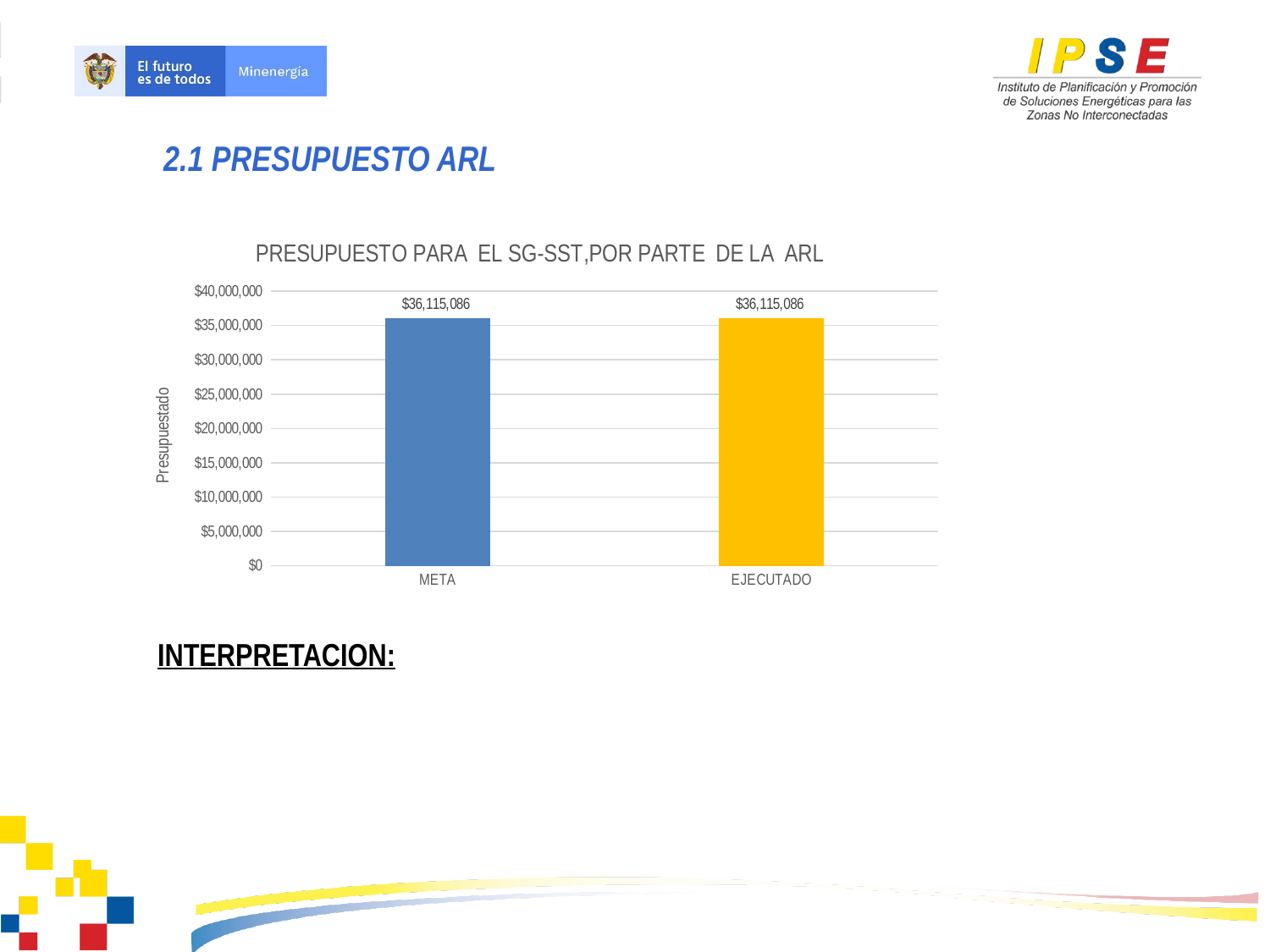
What kind of chart is shown? bar chart What is the total of the META and EJECUTADO values? $72,230,172 What is the title of the chart? PRESUPUESTO PARA EL SG-SST,POR PARTE DE LA ARL Is the value for EJECUTADO greater or less than $40,000,000? less What is the value for EJECUTADO? $36,115,086 What is the value for META? $36,115,086 Is the value for META greater or less than $35,000,000? greater How many categories are shown on the x axis? 2 What is the difference between the META and EJECUTADO values? $0 What is the label of the vertical axis? Presupuestado